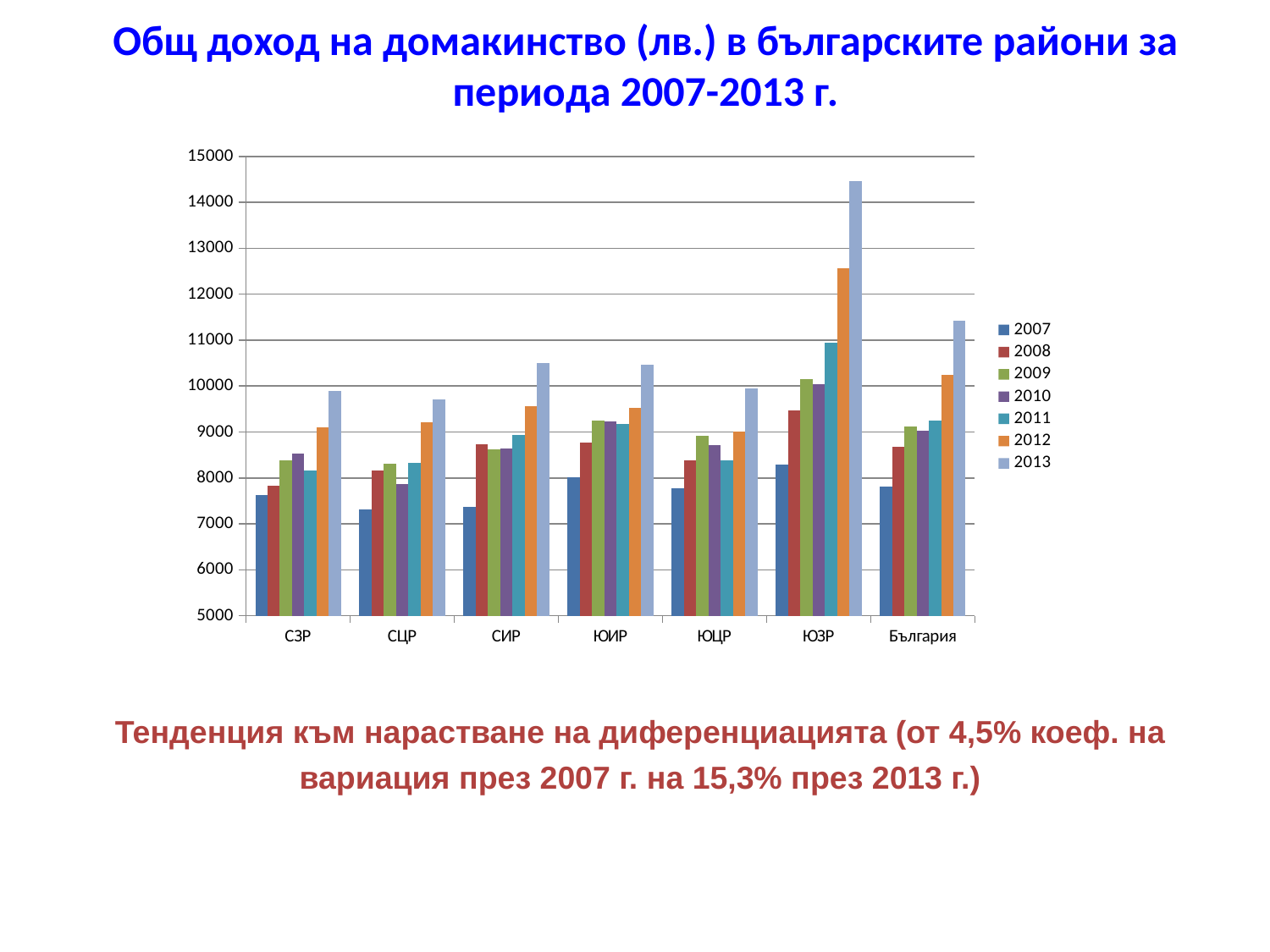
Is the value for България in 2013 greater or less than 11000? greater How many regions (categories) are shown on the x axis of the chart? 7 What kind of chart is shown on the slide? bar chart Is the value for ЮЗР in 2013 greater or less than 14000? greater Is the value for ЮИР in 2007 greater or less than 9000? less From 2007 to 2013, do the values for ЮЗР generally rise or fall? rise How many series does the legend of the chart list? 7 Which is larger, the 2013 value for СЗР or the 2013 value for ЮИР? ЮИР Which year is listed first in the chart's legend? 2007 Which is larger, the 2012 value for ЮЗР or the 2012 value for България? ЮЗР Which region has the highest value for 2013? ЮЗР